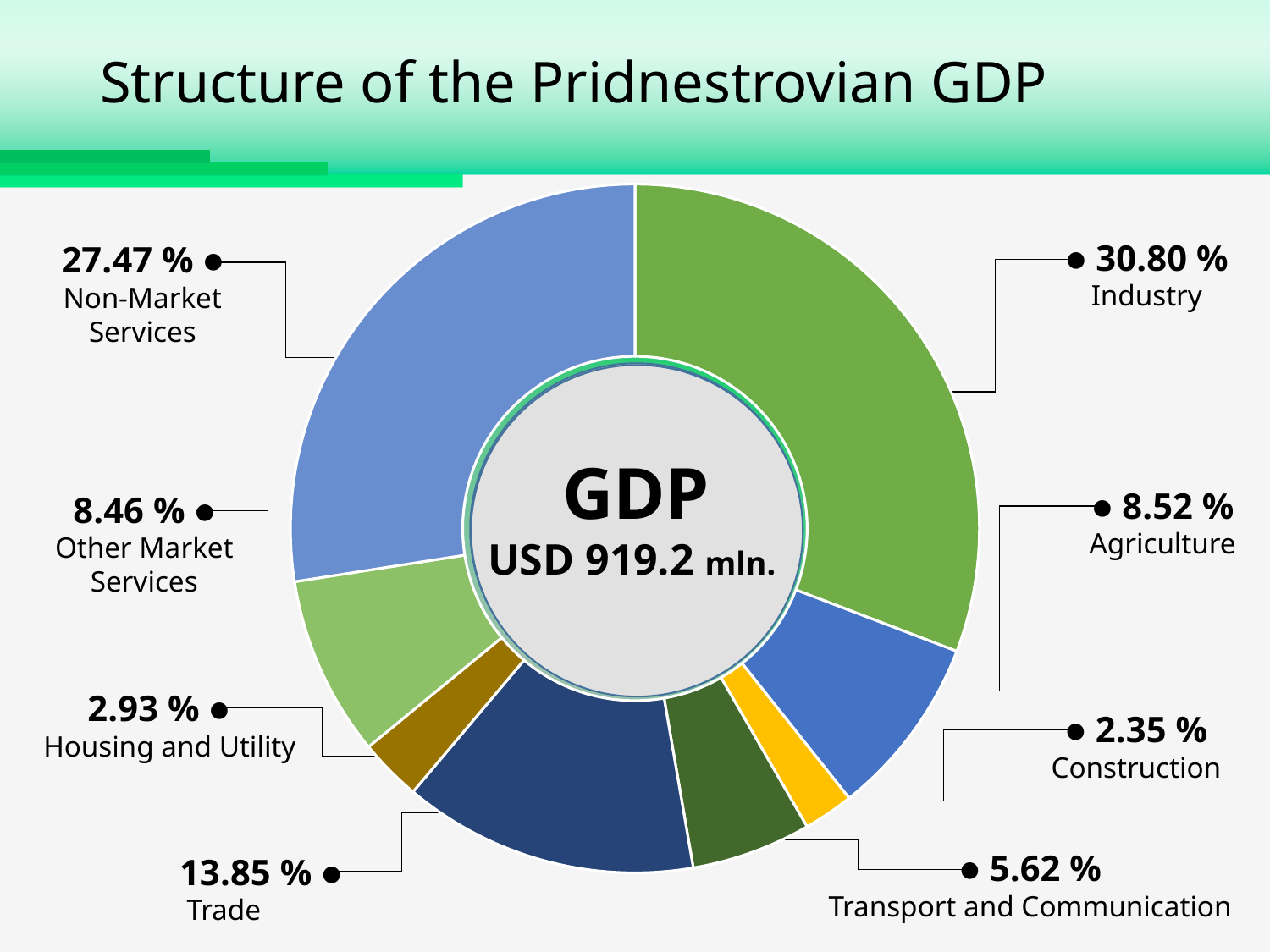
Which sector has the largest share of GDP? Industry Which sector has the smallest share of GDP? Construction What is the title of the slide? Structure of the Pridnestrovian GDP What share of GDP does Trade account for? 13.85 % What is the combined share of Housing and Utility and Construction? 5.28 % What kind of chart is shown on the slide? Doughnut chart Which has a larger share of GDP, Agriculture or Other Market Services? Agriculture What is the difference between the shares of Industry and Non-Market Services? 3.33 % What share of GDP does Transport and Communication account for? 5.62 % How many sectors are shown in the chart? 8 What is the total GDP value shown in the centre of the chart? USD 919.2 mln. What share of GDP does Industry account for? 30.80 %